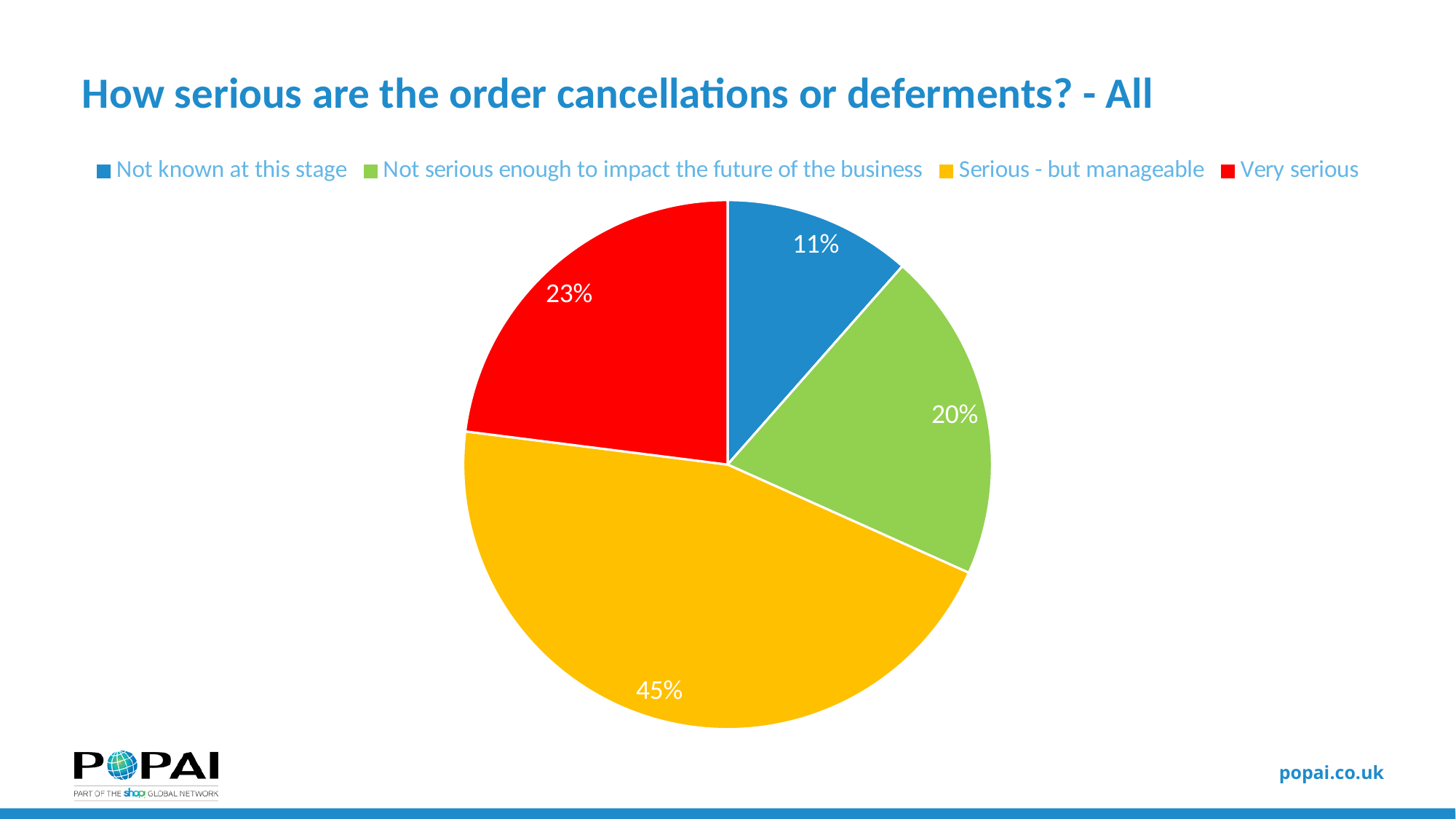
What is the value for 'Not known at this stage'? 11% What is the difference between 'Serious - but manageable' and 'Very serious'? 22% What colour is the 'Very serious' slice? Red What is the value for 'Very serious'? 23% Which is larger, 'Very serious' or 'Not serious enough to impact the future of the business'? Very serious What is the value for 'Not serious enough to impact the future of the business'? 20% What share of the pie is 'Serious - but manageable'? 45% How many categories does the pie chart show? 4 Which category has the largest slice of the pie? Serious - but manageable What kind of chart is shown on the slide? Pie chart What is the difference between 'Very serious' and 'Not known at this stage'? 12% Which category has the smallest slice of the pie? Not known at this stage